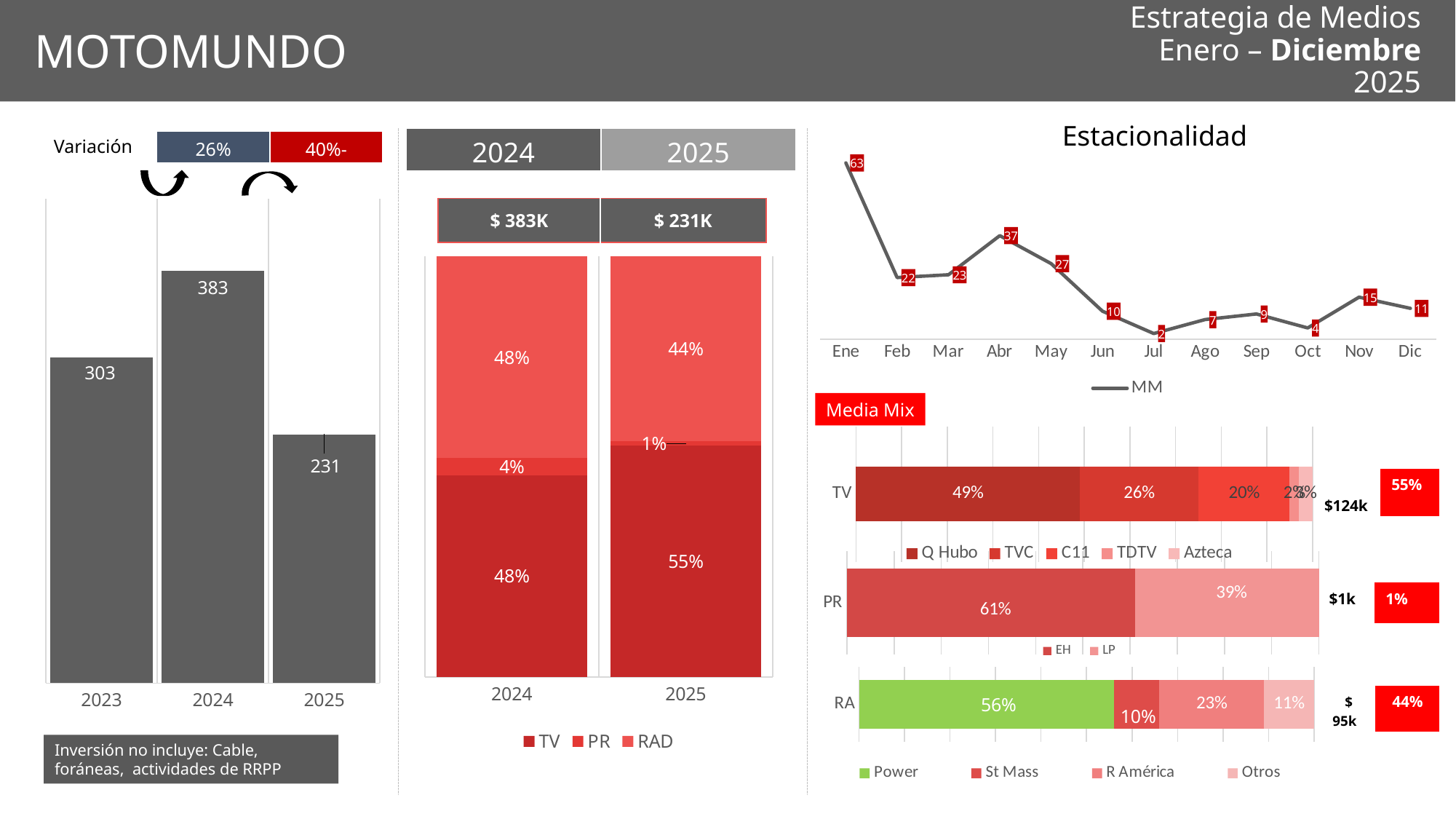
In the left bar chart of investment by year, which year has the lowest value? 2025 In the Estacionalidad chart, which month has the lowest value? Jul In the middle stacked bar chart (2024 vs 2025), what share does PR have in 2024? 4% In the Estacionalidad chart, what is the value for Abr? 37 In the Media Mix chart, what share does Q Hubo have in the TV bar? 49% In the left bar chart of investment by year, what is the difference between the 2024 and 2025 values? 152 In the middle stacked bar chart (2024 vs 2025), how many series does the legend list? 3 In the left bar chart of investment by year, what is the value for 2024? 383 In the Estacionalidad chart, what kind of chart is it? line chart In the left bar chart of investment by year, how many years are shown? 3 In the Media Mix chart, what share does Power have in the RA bar? 56% In the middle stacked bar chart (2024 vs 2025), what share does TV have in 2025? 55%